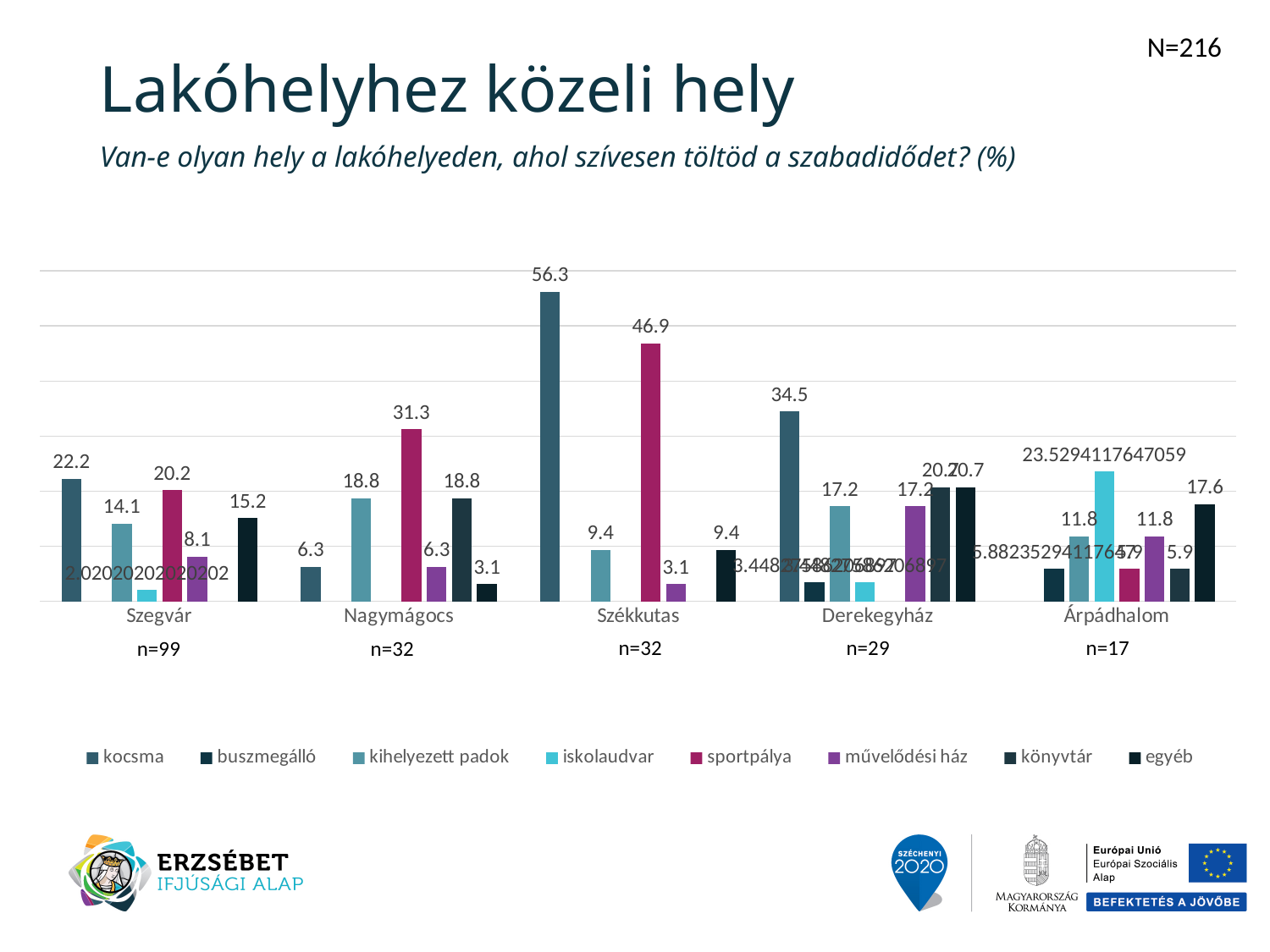
What is the value for egyéb in Árpádhalom? 17.6 What kind of chart is shown on the slide? bar chart What is the value for kocsma in Székkutas? 56.3 What is the difference between the kocsma and sportpálya values in Székkutas? 9.4 What is the sample size (n) shown for Szegvár? n=99 How many series does the legend list? 8 How many settlements (categories) are shown on the x axis? 5 What is the value for kocsma in Derekegyház? 34.5 Which settlement has the highest value for kocsma? Székkutas What is the difference between sportpálya and kihelyezett padok in Nagymágocs? 12.5 What is the value for sportpálya in Nagymágocs? 31.3 In Szegvár, which is larger: kocsma or sportpálya? kocsma